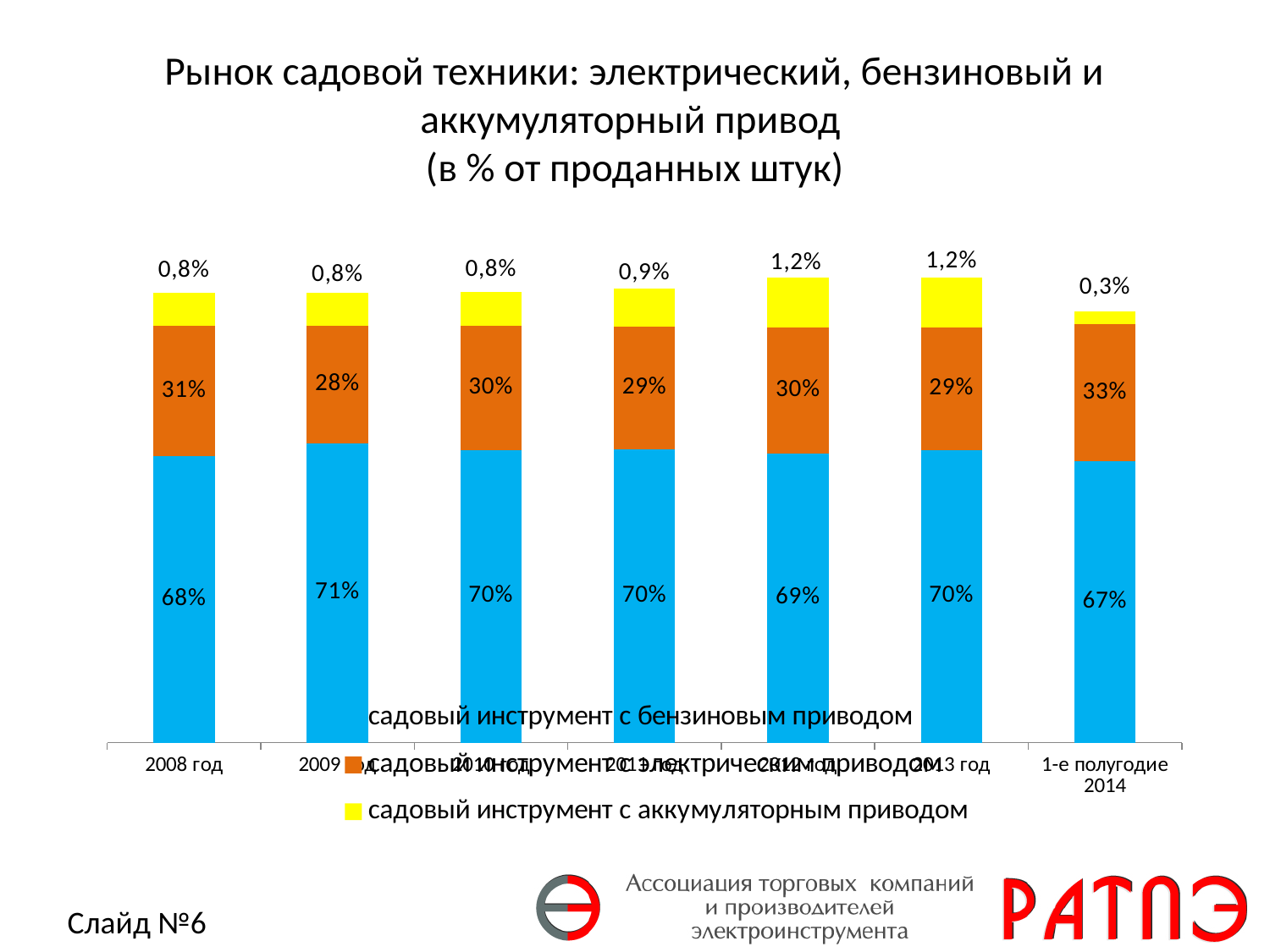
Which is larger: the yellow segment value for 2013 год or for 2008 год? 2013 год How many categories (time periods) are shown on the x axis? 7 What is the value for садовый инструмент с аккумуляторным приводом (yellow segment) in 2013 год? 1,2% What kind of chart is shown on the slide? stacked bar chart How many series does the legend list? 3 What is the third series listed in the legend? садовый инструмент с аккумуляторным приводом Which category has the lowest value for the yellow (top) segment? 1-е полугодие 2014 Which category has the highest value for the blue (bottom) segment? 2009 год What is the value of the orange (middle) segment for 1-е полугодие 2014? 33% What is the value of the blue (bottom) segment for 2008 год? 68% Which category has the lowest value for the blue (bottom) segment? 1-е полугодие 2014 What is the difference between the orange segment values for 1-е полугодие 2014 and 2008 год? 2 percentage points